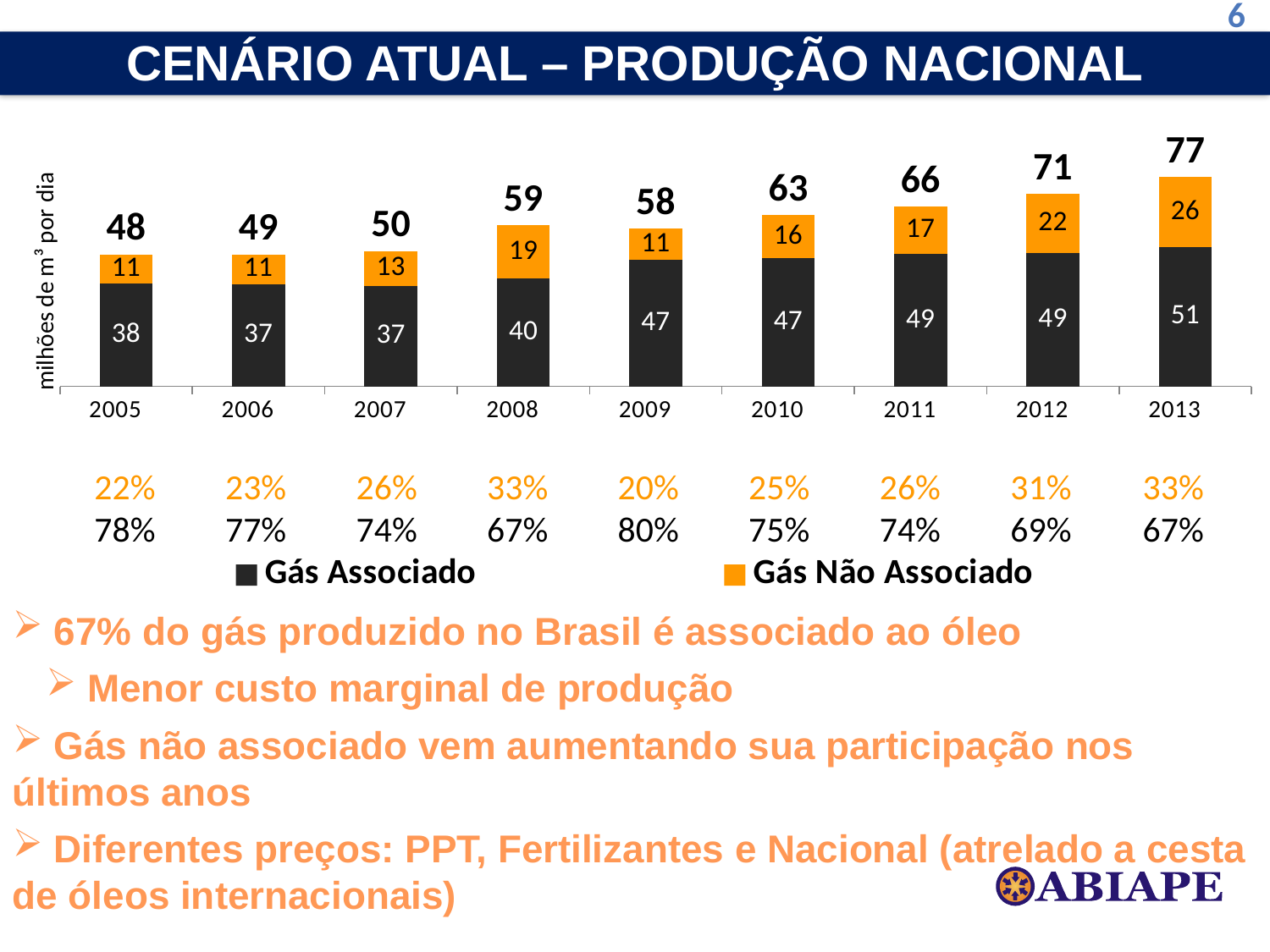
What is the total printed above the bar for 2010? 63 How many years are shown on the x axis? 9 What colour represents Gás Não Associado in the chart? Orange What is the value of Gás Não Associado in 2008? 19 What is the value of Gás Associado in 2013? 51 What type of chart is shown on the slide? Stacked bar chart Which year has the highest total production? 2013 Which is larger, Gás Associado in 2009 or Gás Associado in 2008? Gás Associado in 2009 Which year has the lowest total production? 2005 How many series does the legend list? 2 Do the total values generally rise or fall from 2005 to 2013? Rise What is the difference between Gás Não Associado in 2013 and in 2012? 4